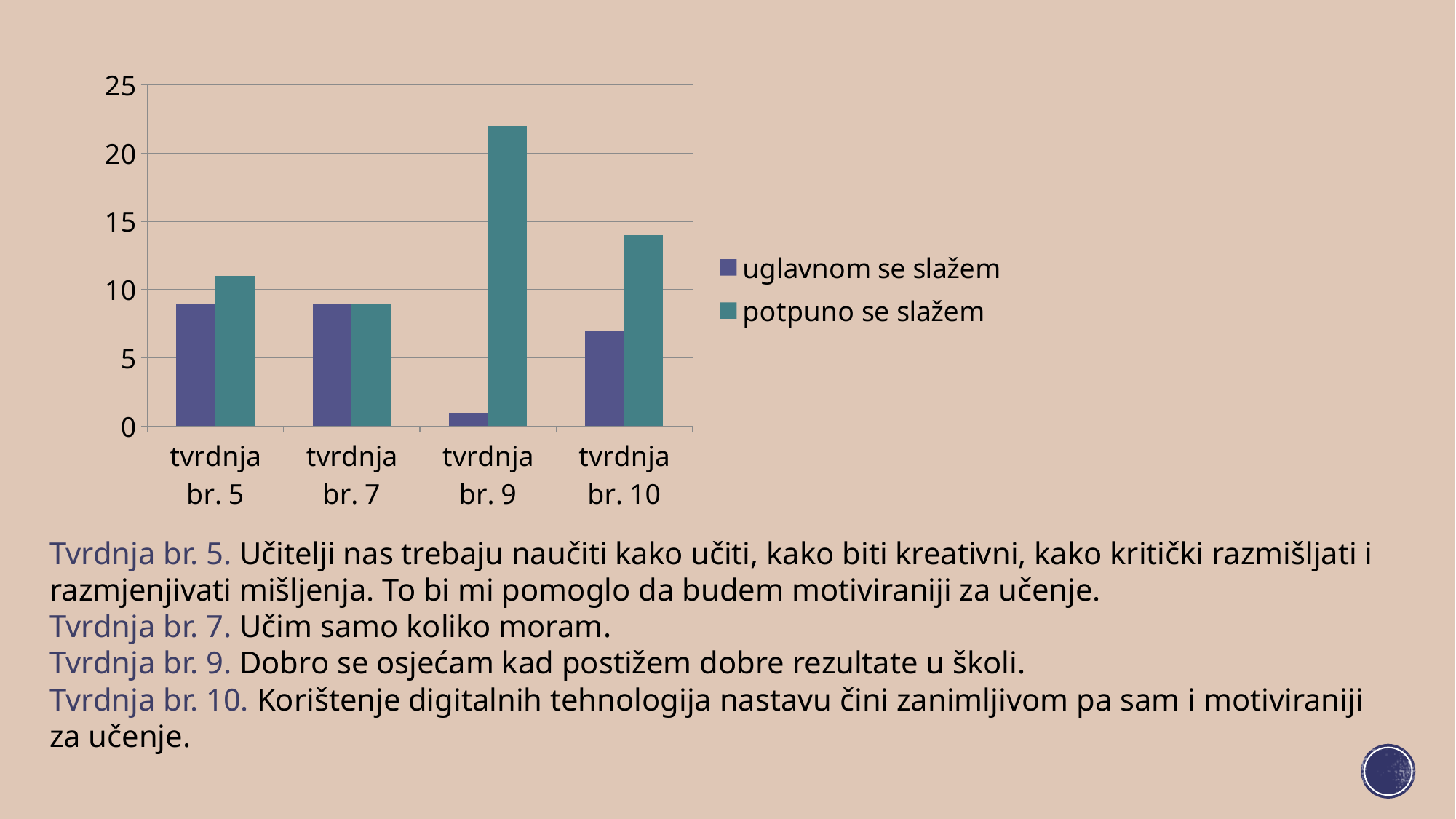
Is the value for "uglavnom se slažem" at tvrdnja br. 9 greater or less than 5? less For tvrdnja br. 9, which series has the larger value, "uglavnom se slažem" or "potpuno se slažem"? potpuno se slažem How many series does the chart's legend list? 2 Which series in the chart is drawn in teal (green-blue) bars? potpuno se slažem What kind of chart is shown on the slide? bar chart Which category has the lowest value for the series "uglavnom se slažem"? tvrdnja br. 9 For tvrdnja br. 10, which series has the larger value, "uglavnom se slažem" or "potpuno se slažem"? potpuno se slažem Is the value for "uglavnom se slažem" at tvrdnja br. 10 greater or less than 5? greater Is the value for "potpuno se slažem" at tvrdnja br. 9 greater or less than 20? greater Which category has the highest value for the series "potpuno se slažem"? tvrdnja br. 9 How many categories (tvrdnje) are shown on the x axis of the chart? 4